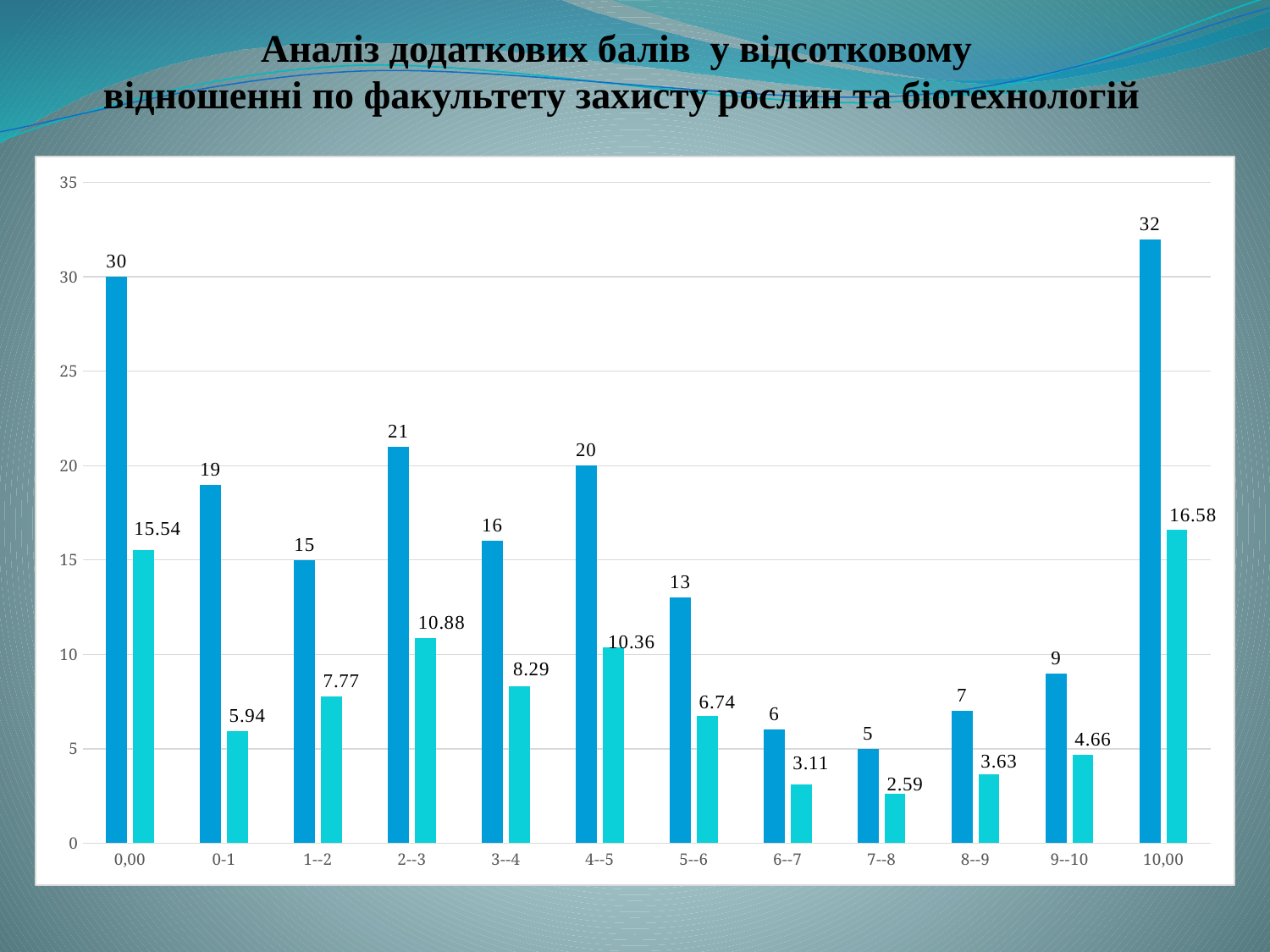
Which is larger: the light cyan bar for 2--3 or the light cyan bar for 4--5? 2--3 Which category has the lowest light cyan bar? 7--8 Which category has the highest dark blue bar? 10,00 What is the value of the light cyan bar for the category 0,00? 15.54 What is the difference between the light cyan bar values for 10,00 and 9--10? 11.92 What is the difference between the dark blue bar values for 10,00 and 0,00? 2 What kind of chart is shown on the slide? bar chart What is the value of the light cyan bar for the category 7--8? 2.59 Is the dark blue bar for 5--6 greater or less than 10? greater How many categories are shown on the x axis? 12 What is the value of the dark blue bar for the category 8--9? 7 What is the value of the dark blue bar for the category 2--3? 21